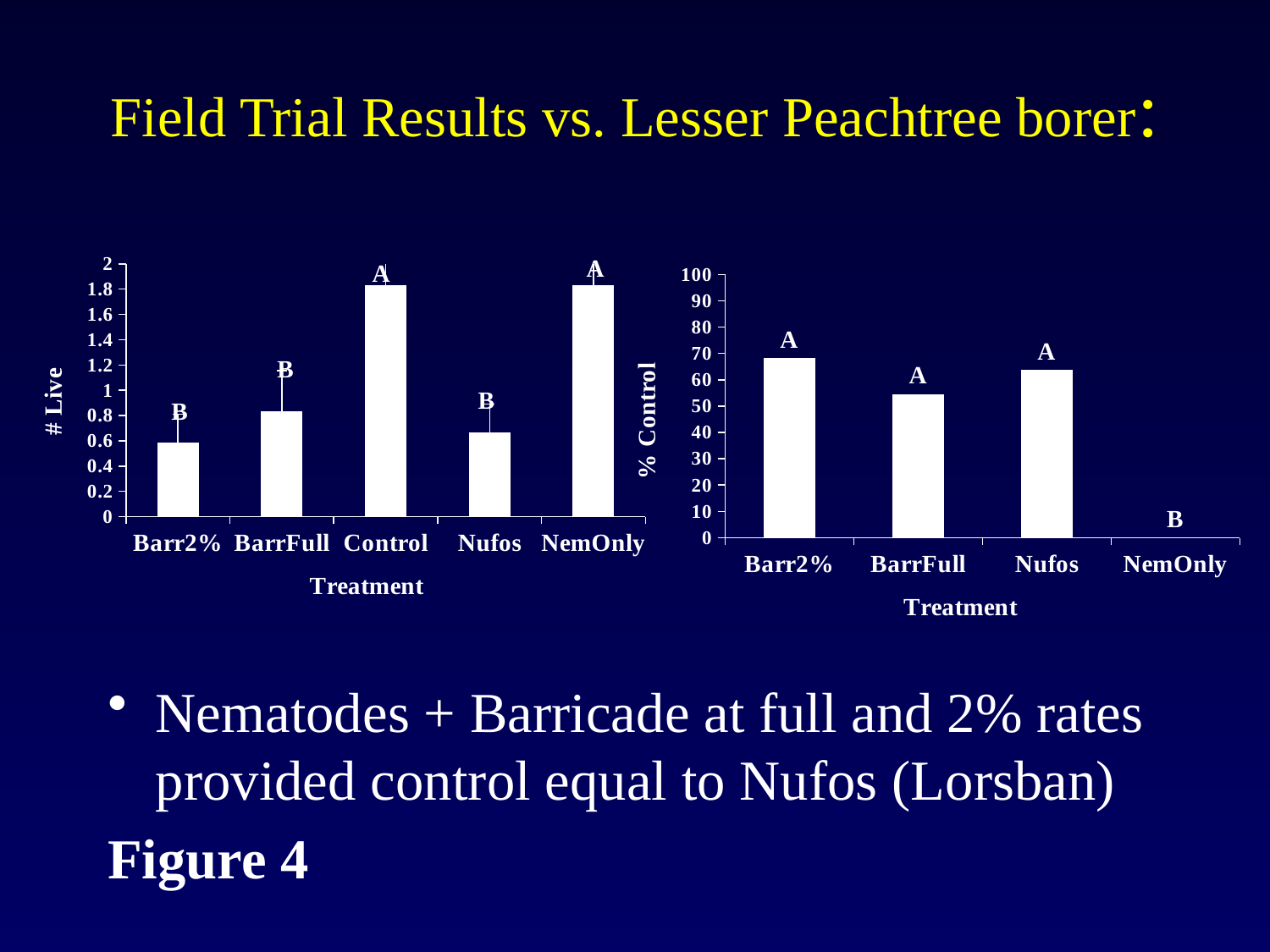
In the left chart (# Live), is the value for Barr2% greater or less than 0.8? less In the left chart (# Live), which is larger, the value for Control or the value for Nufos? Control In the right chart (% Control), is the value for Barr2% greater or less than 60? greater In the right chart (% Control), which treatment has the lowest % Control? NemOnly How many treatments are shown on the x axis of the left chart (# Live)? 5 What is the y-axis title of the right chart? % Control In the right chart (% Control), is the value for BarrFull greater or less than 60? less What kind of chart is the left chart (# Live)? bar chart How many treatments are shown on the x axis of the right chart (% Control)? 4 In the right chart (% Control), which treatment has the highest % Control? Barr2%